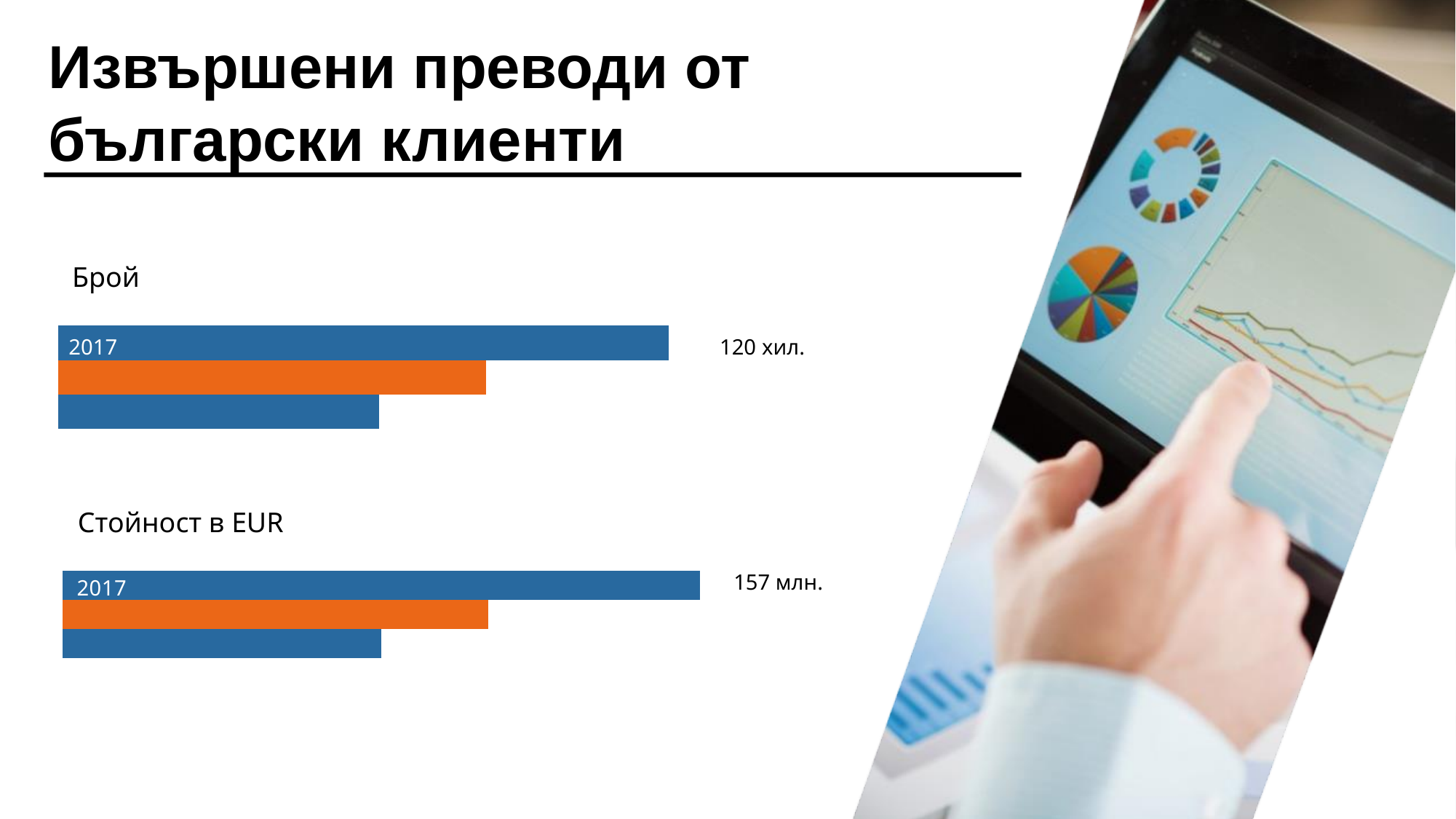
What is the title of the upper chart on the slide? Брой In the "Брой" chart, what value is shown for 2017? 120 хил. What kind of chart is the "Брой" chart? bar chart In the "Стойност в EUR" chart, what value is shown for 2017? 157 млн. How many bars are plotted in the "Брой" chart? 3 How many bars are plotted in the "Стойност в EUR" chart? 3 In the "Стойност в EUR" chart, is the 2017 bar longer or shorter than the orange bar below it? longer In the "Брой" chart, which labelled bar is the longest? 2017 What kind of chart is the "Стойност в EUR" chart? bar chart In the "Брой" chart, do the bars get longer or shorter going from top to bottom? shorter What colour is the middle bar in the "Стойност в EUR" chart? orange